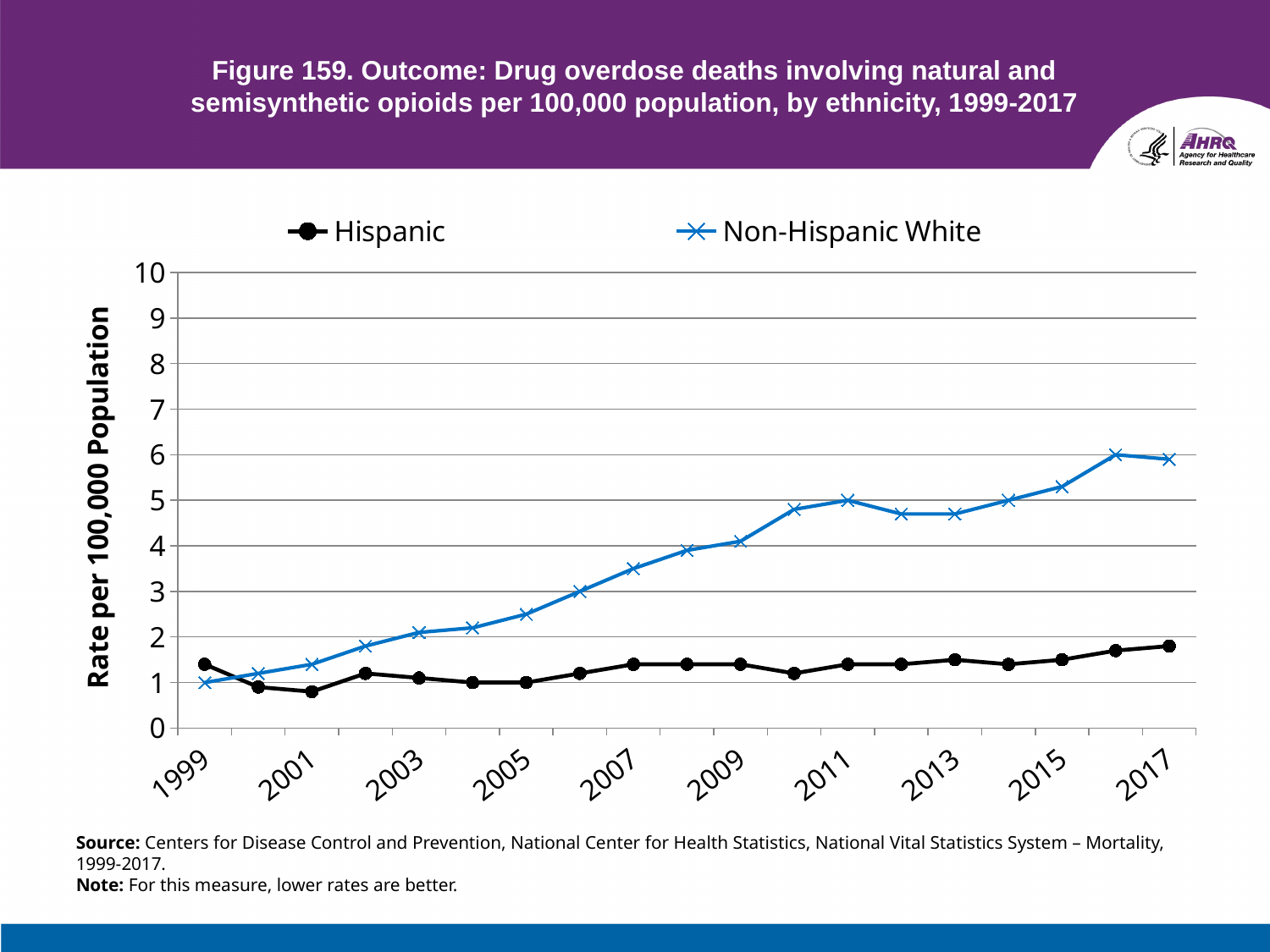
Is the value for Non-Hispanic White in 2017 greater or less than 5? greater How many years are plotted for each series? 19 What is the rate for Non-Hispanic White in 1999? 1 What is the rate for Hispanic in 2005? 1 What kind of chart is shown on the slide? Line chart Which two groups are shown in the legend? Hispanic and Non-Hispanic White In 2017, which group has the higher rate, Hispanic or Non-Hispanic White? Non-Hispanic White What is the rate for Non-Hispanic White in 2016? 6 What is the label on the vertical axis? Rate per 100,000 Population How many series does the legend list? 2 Is the value for Hispanic in 2017 greater or less than 2? less Does the Non-Hispanic White rate generally rise or fall from 1999 to 2017? Rise